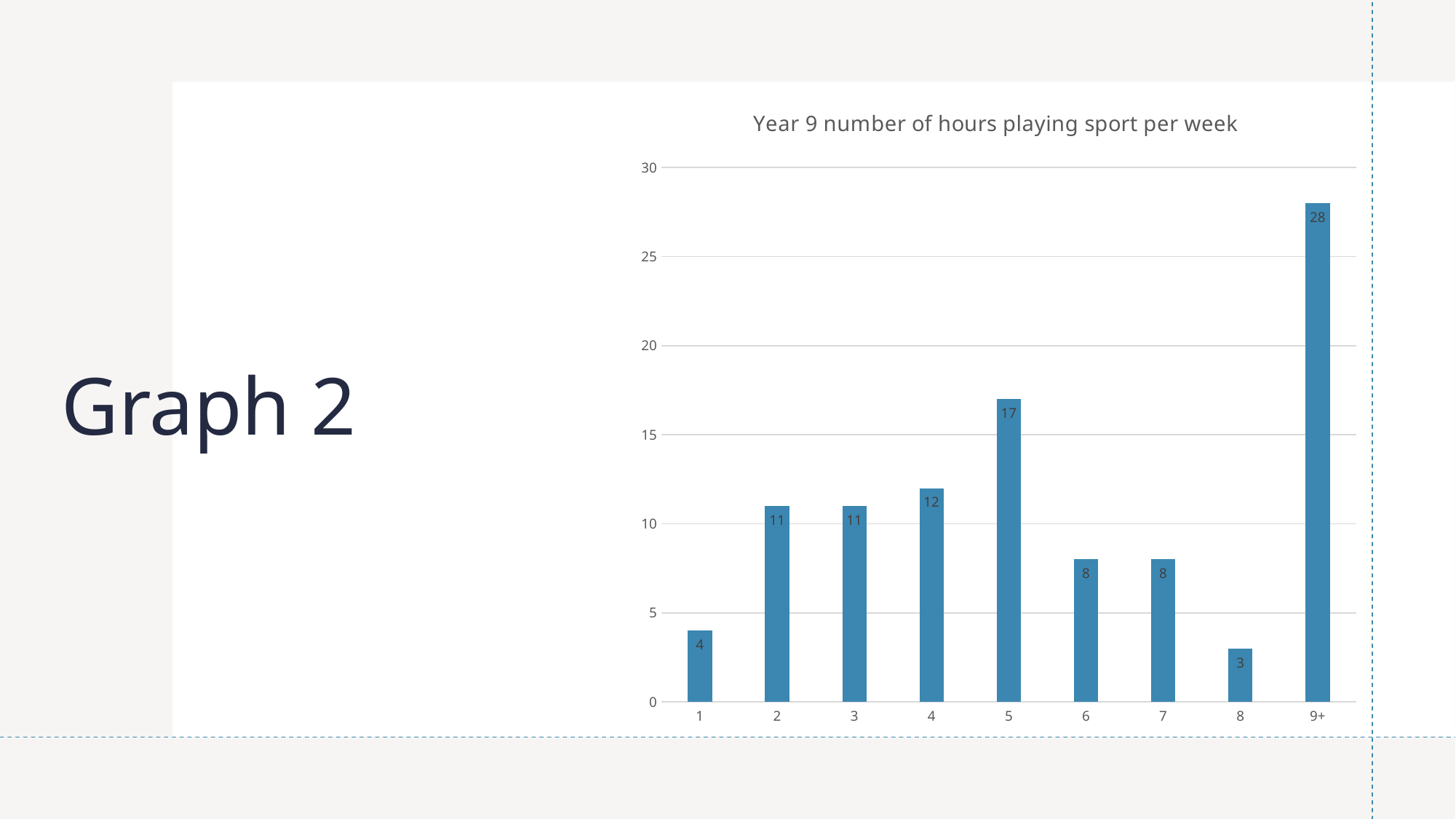
How many categories are shown on the x axis? 9 Which category has the highest value? 9+ What kind of chart is this? bar chart What is the difference between the values for 9+ and 5? 11 Which category has the lowest value? 8 What is the value for category 9+? 28 What is the title of the chart? Year 9 number of hours playing sport per week Which is larger, the value for 4 or the value for 6? 4 What is the difference between the values for 2 and 8? 8 What is the value for category 1? 4 Is the value for 9+ greater or less than 25? greater What is the value for category 5? 17